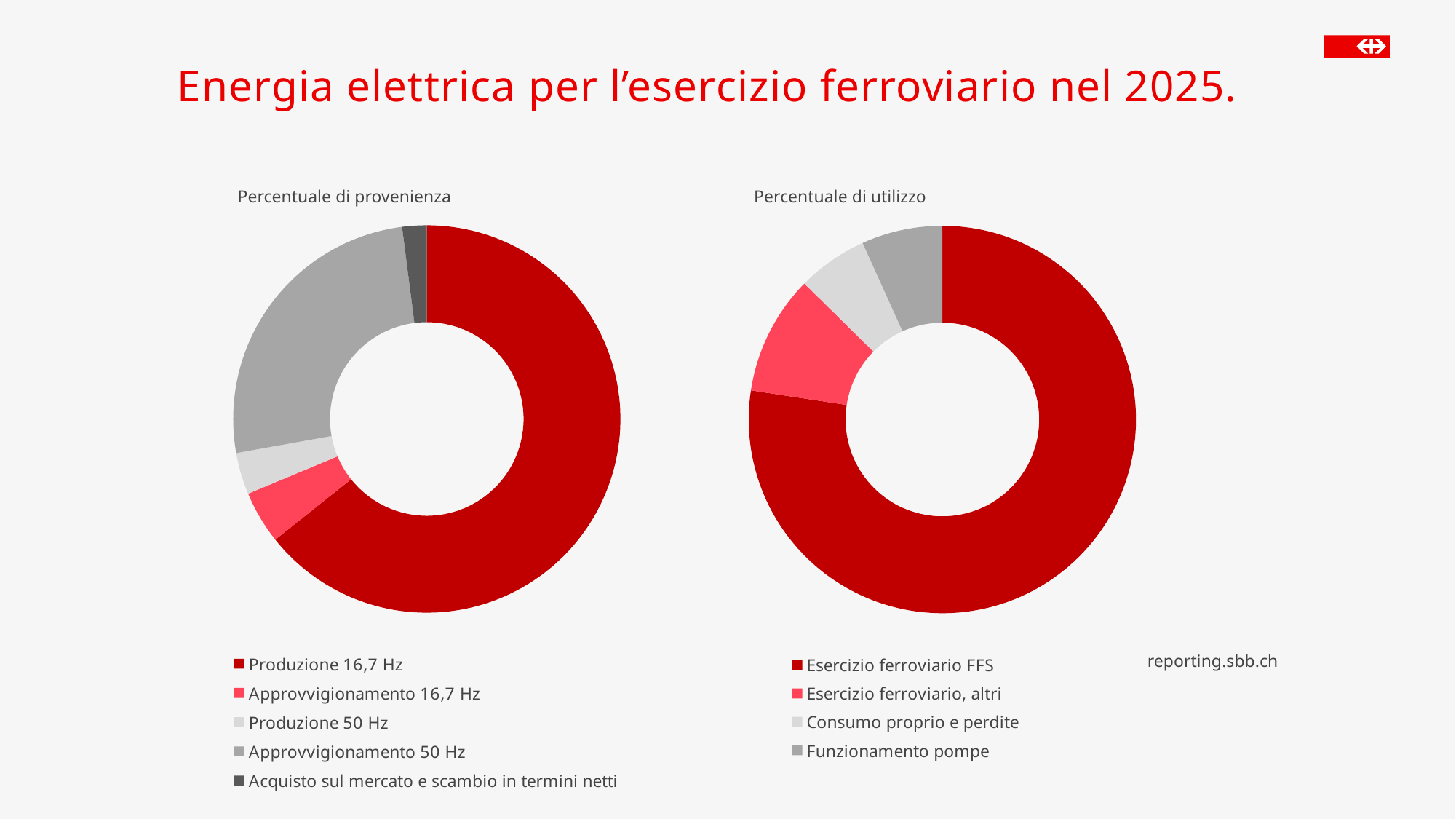
In the 'Percentuale di provenienza' chart, which is larger: Produzione 50 Hz or Approvvigionamento 50 Hz? Approvvigionamento 50 Hz In the 'Percentuale di provenienza' chart, how many categories does the legend list? 5 In the 'Percentuale di provenienza' chart, which category has the smallest share? Acquisto sul mercato e scambio in termini netti What is the title of the slide? Energia elettrica per l'esercizio ferroviario nel 2025. In the 'Percentuale di utilizzo' chart, which legend entry is shown in dark red? Esercizio ferroviario FFS What kind of chart is the 'Percentuale di provenienza' chart? Pie chart (donut) In the 'Percentuale di provenienza' chart, which category has the largest share? Produzione 16,7 Hz What kind of chart is the 'Percentuale di utilizzo' chart? Pie chart (donut) In the 'Percentuale di utilizzo' chart, which is larger: Esercizio ferroviario, altri or Funzionamento pompe? Esercizio ferroviario, altri In the 'Percentuale di utilizzo' chart, how many categories does the legend list? 4 In the 'Percentuale di provenienza' chart, which is larger: Approvvigionamento 50 Hz or Approvvigionamento 16,7 Hz? Approvvigionamento 50 Hz In the 'Percentuale di utilizzo' chart, which category has the largest share? Esercizio ferroviario FFS